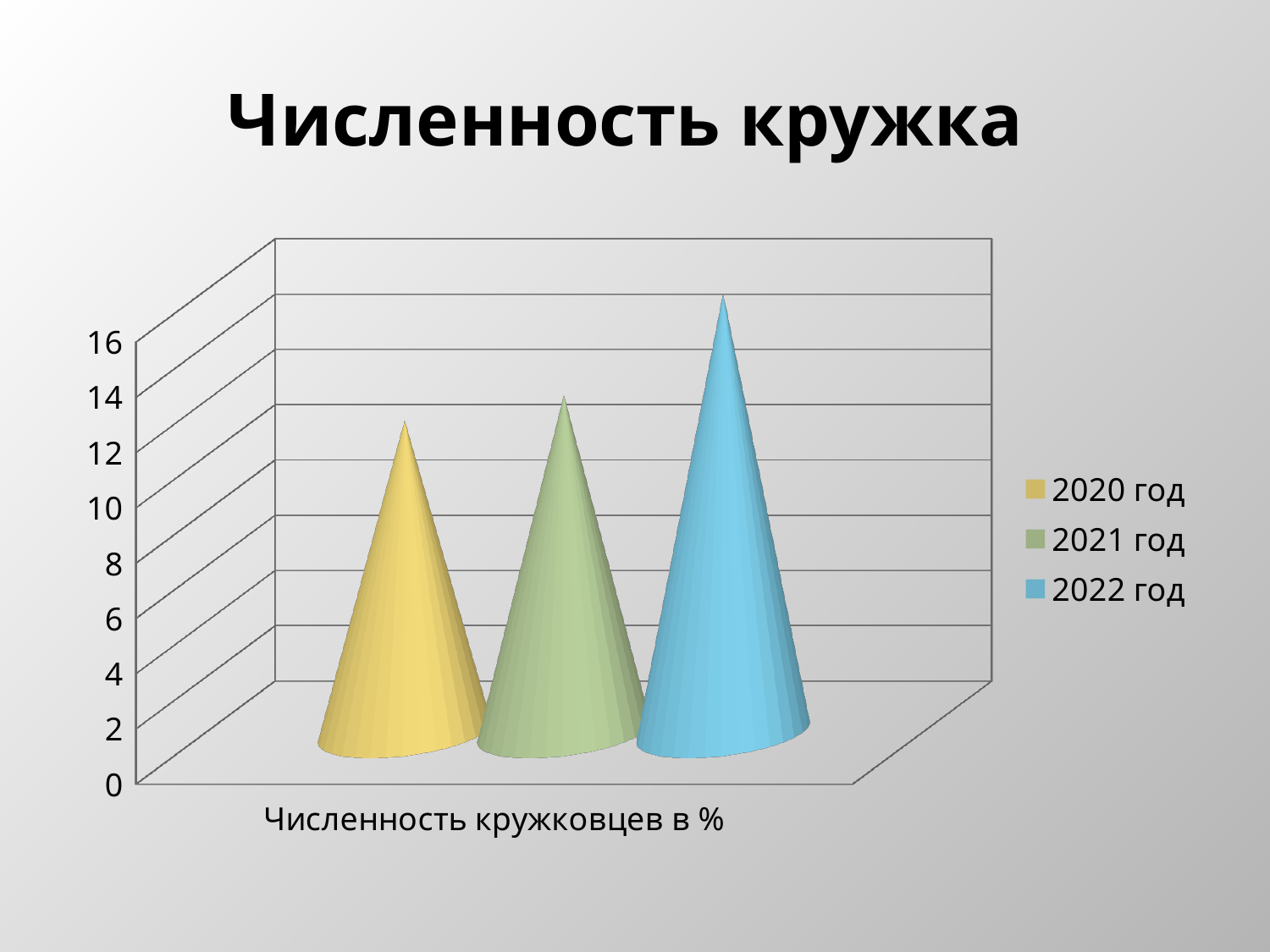
What kind of chart is shown on the slide? bar chart How many categories are shown on the x axis? 1 Do the values rise or fall from 2020 год to 2022 год? rise Which is larger, the value for 2021 год or the value for 2020 год? 2021 год How many series does the legend list? 3 Which year has the highest value for Численность кружковцев в %? 2022 год Is the value for 2022 год greater or less than 14? greater What is the title of the chart on the slide? Численность кружка Which colour represents 2022 год in the legend? blue Is the value for 2021 год greater or less than 14? less Which year has the lowest value for Численность кружковцев в %? 2020 год Is the value for 2020 год greater or less than 8? greater